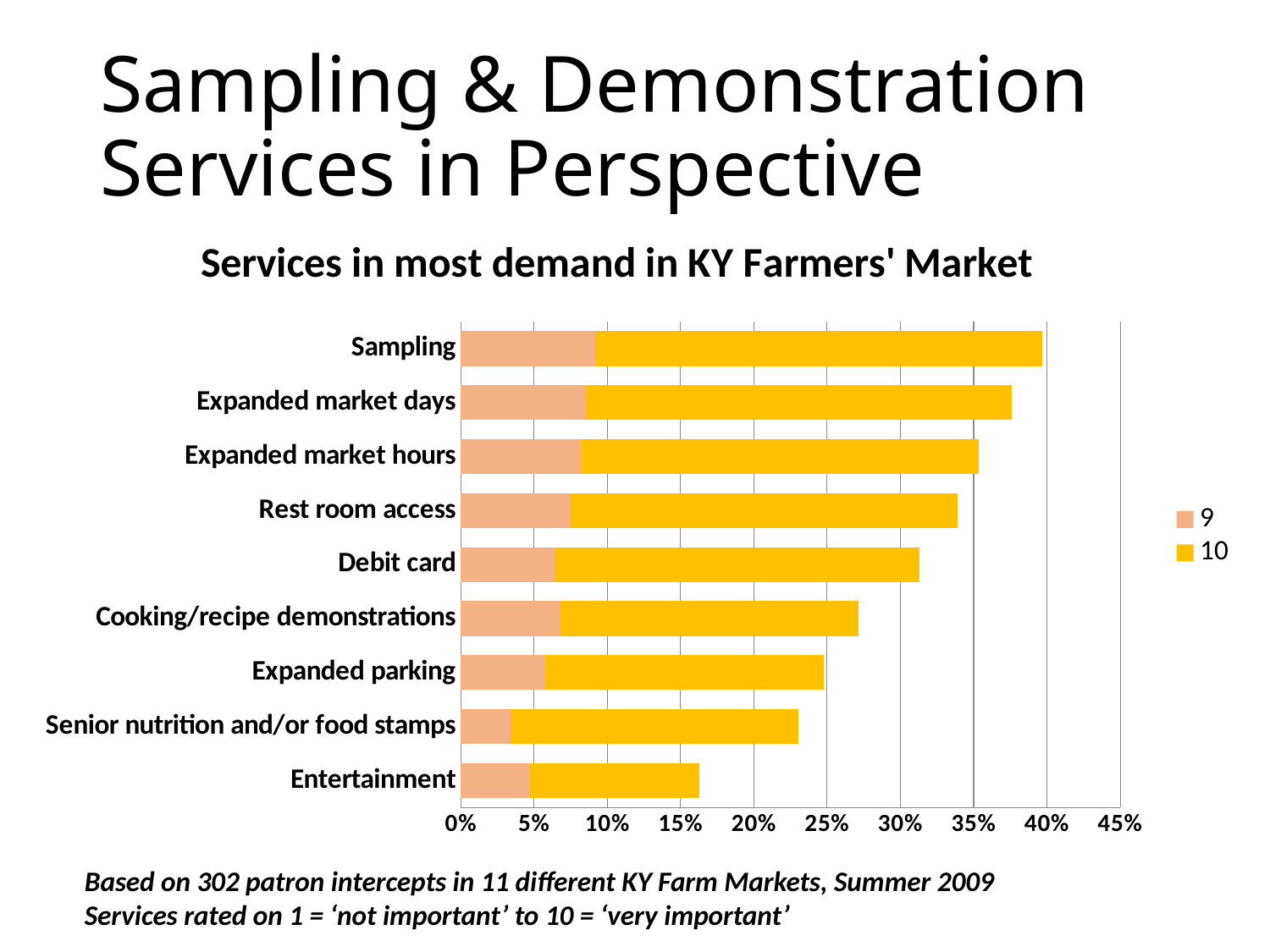
How many service categories are plotted in the chart? 9 Which has a longer total bar, Rest room access or Expanded parking? Rest room access What is the title of the chart? Services in most demand in KY Farmers' Market Which legend entry is shown in the darker yellow colour? 10 Is the total bar for Entertainment greater or less than 20%? less Is the total bar for Sampling greater or less than 35%? greater Which service has the shortest total bar? Entertainment How many series does the legend list? 2 Is the total bar for Senior nutrition and/or food stamps greater or less than 25%? less What kind of chart is shown on the slide? Stacked bar chart Which service has the longest total bar? Sampling